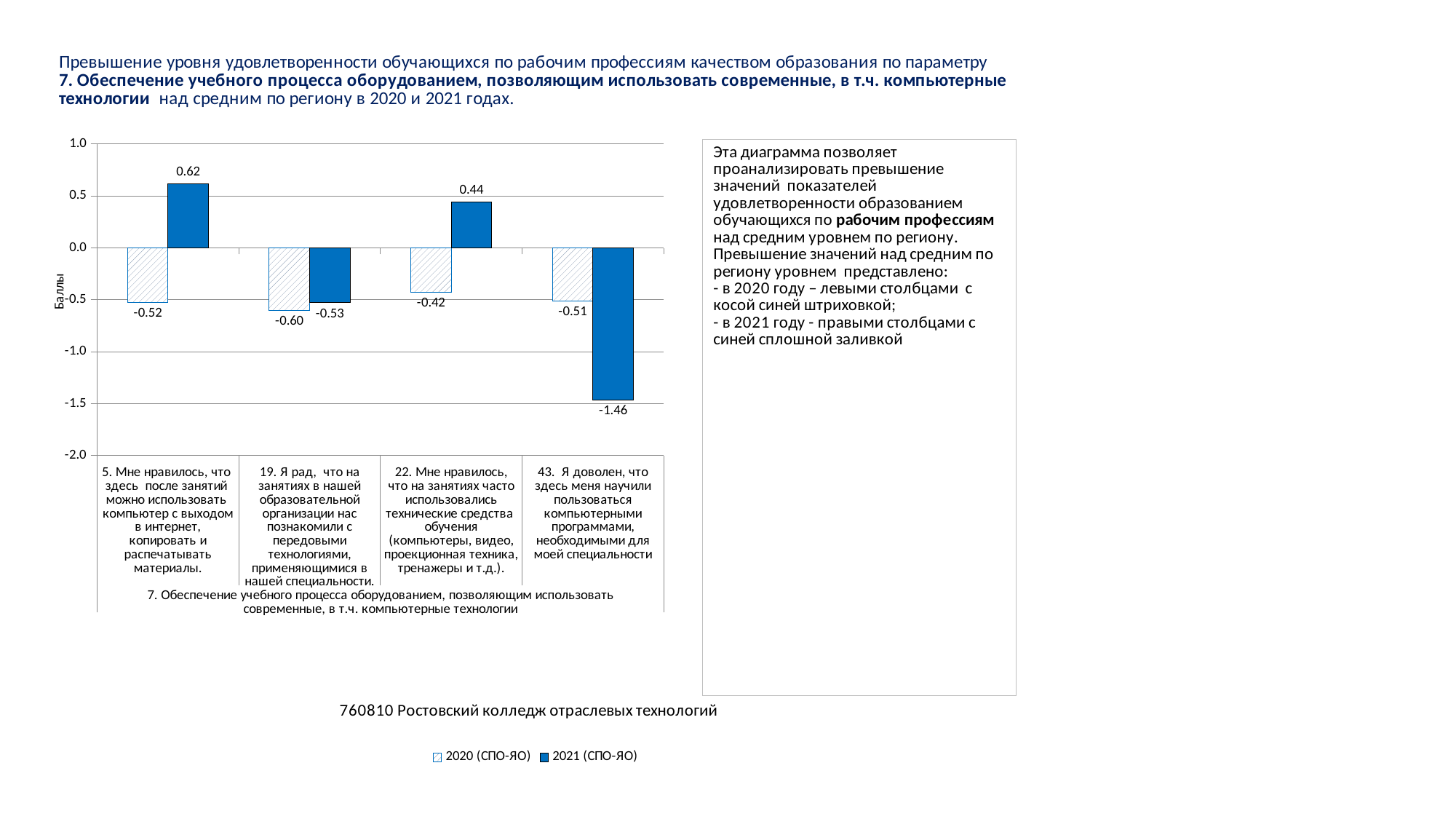
What is the value for 2020 (СПО-ЯО) for category 19 ("Я рад, что на занятиях в нашей образовательной организации нас познакомили с передовыми технологиями...")? -0.60 Which category has the lowest value for the 2021 (СПО-ЯО) series? 43. Я доволен, что здесь меня научили пользоваться компьютерными программами, необходимыми для моей специальности What is the value for 2021 (СПО-ЯО) for category 43 ("Я доволен, что здесь меня научили пользоваться компьютерными программами...")? -1.46 What is the difference between the 2021 (СПО-ЯО) and 2020 (СПО-ЯО) values for category 5? 1.14 How many categories are shown on the x axis of the chart? 4 What is the value for 2020 (СПО-ЯО) for category 22 ("Мне нравилось, что на занятиях часто использовались технические средства обучения...")? -0.42 What is the value for 2021 (СПО-ЯО) for category 5 ("Мне нравилось, что здесь после занятий можно использовать компьютер...")? 0.62 Is the 2021 (СПО-ЯО) value for category 22 greater or less than 0.5? less Which category has the highest value for the 2021 (СПО-ЯО) series? 5. Мне нравилось, что здесь после занятий можно использовать компьютер с выходом в интернет, копировать и распечатывать материалы. For category 43, which series has the larger value, 2020 (СПО-ЯО) or 2021 (СПО-ЯО)? 2020 (СПО-ЯО) How many series does the chart legend list? 2 What type of chart is shown on the slide? Bar chart